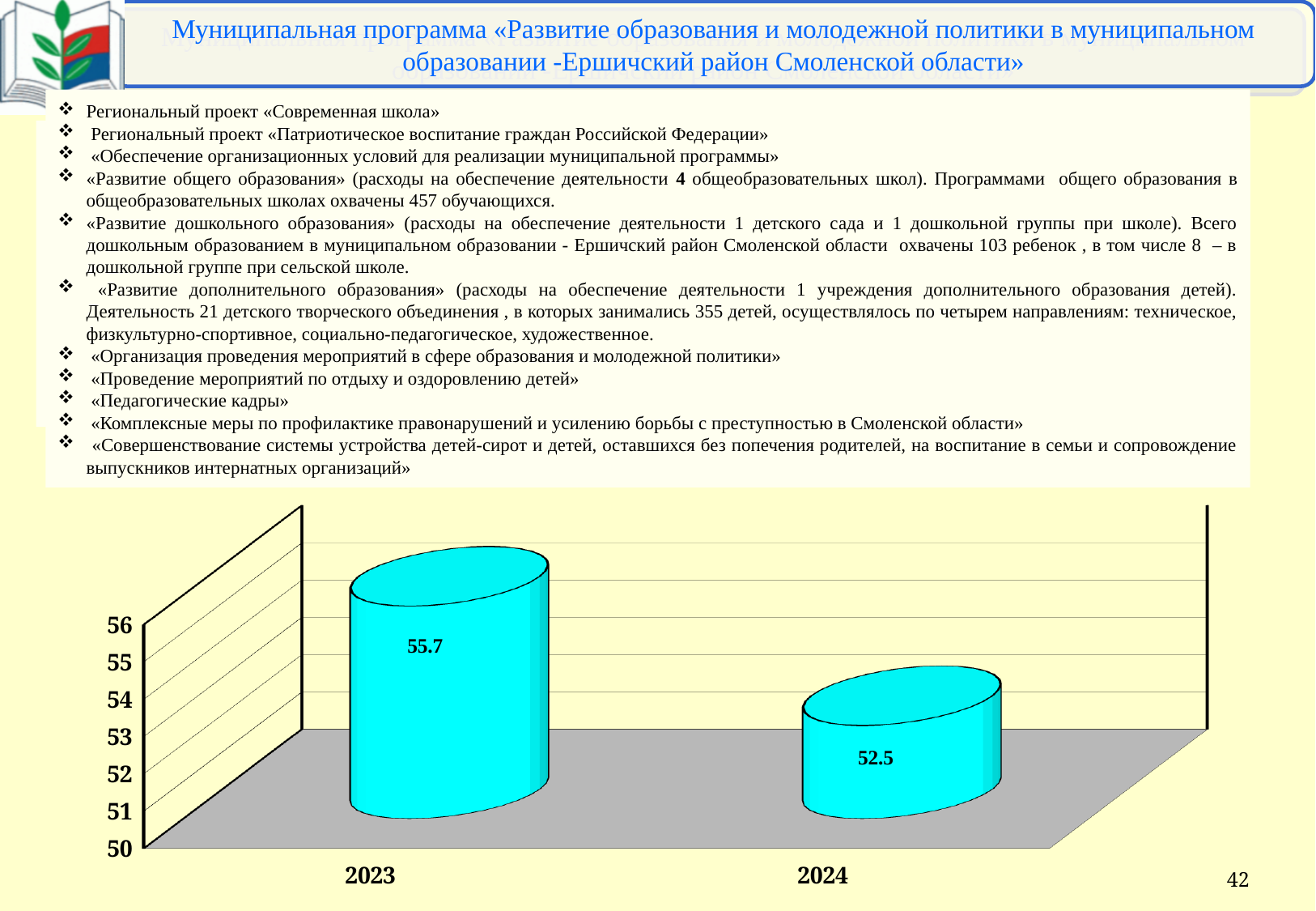
Is the value for 2023 greater or less than 55? greater Which is larger, the value for 2023 or the value for 2024? 2023 What kind of chart is shown on the slide? bar chart Which year has the lowest value? 2024 What is the lowest value shown on the chart's vertical axis? 50 What is the value for 2024? 52.5 Is the value for 2024 greater or less than 53? less How many categories are shown on the x axis of the chart? 2 What is the difference between the values for 2023 and 2024? 3.2 What is the value for 2023? 55.7 Do the values rise or fall from 2023 to 2024? fall Which year has the highest value? 2023